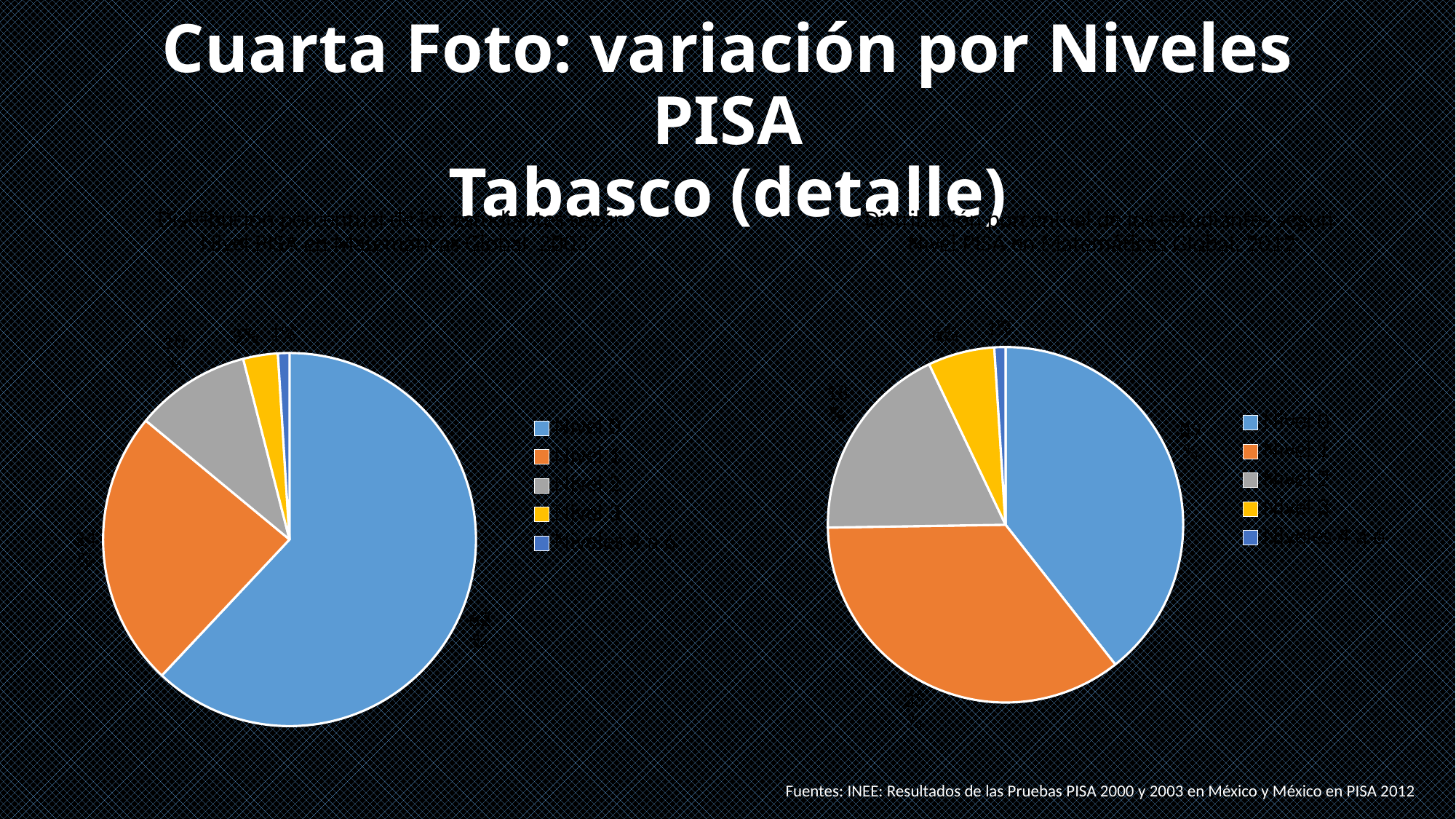
How many entries does the legend of the left pie chart list? 5 How many slices does the pie chart on the right have? 5 How many entries does the legend of the right pie chart list? 5 What kind of chart is the chart on the right of the slide? pie chart How many slices does the pie chart on the left have? 5 In the pie chart on the left, which colour slice is the smallest? dark blue What kind of chart is the chart on the left of the slide? pie chart In the pie chart on the right, which is larger, the grey slice or the yellow slice? grey In the pie chart on the right, which colour slice is the smallest? dark blue In the pie chart on the right, which colour slice is the largest? light blue In the pie chart on the left, which is larger, the orange slice or the grey slice? orange In the pie chart on the left, which colour slice is the largest? light blue